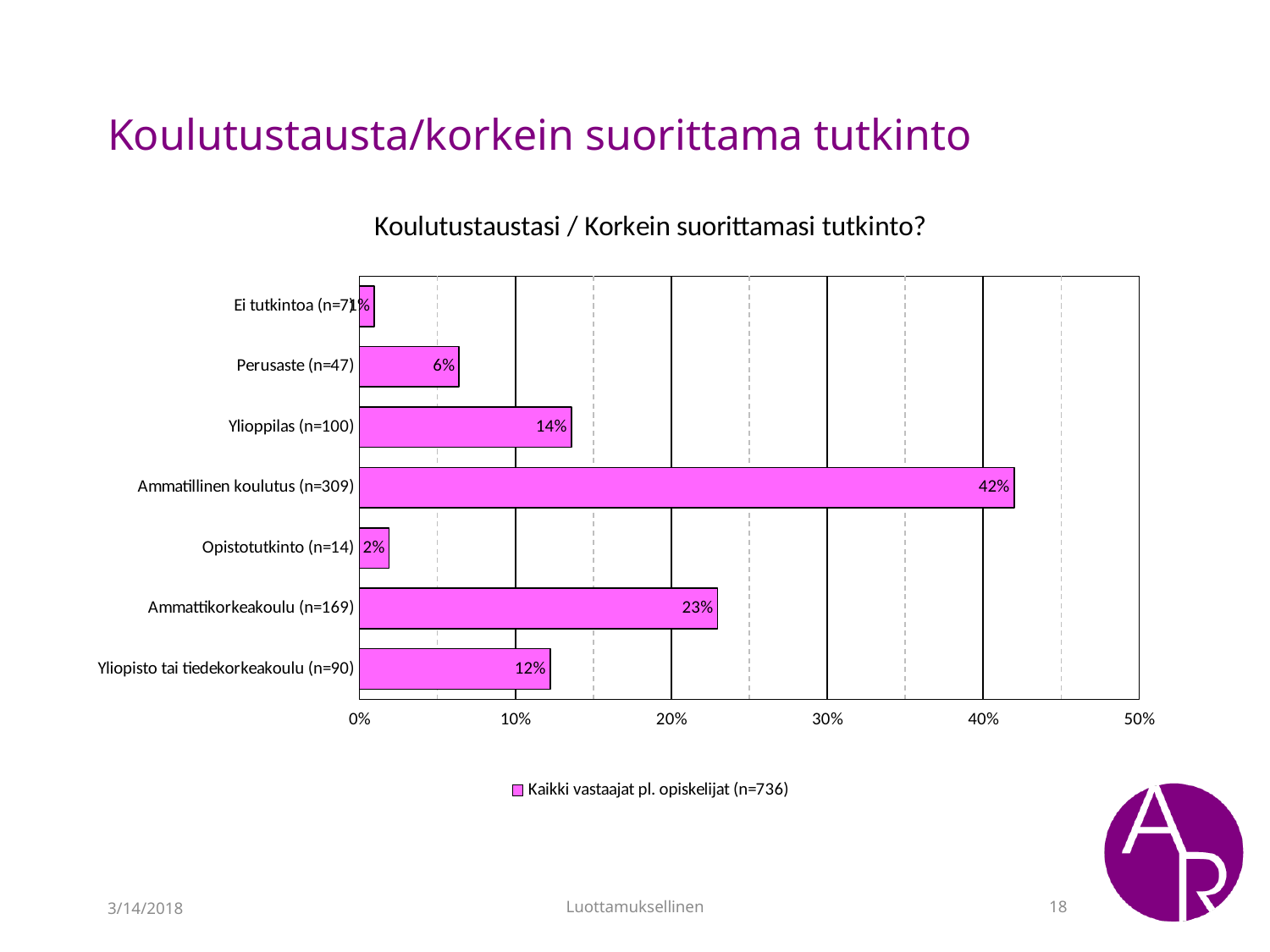
What is the value for Ammatillinen koulutus (n=309)? 42% What is the legend entry of the chart? Kaikki vastaajat pl. opiskelijat (n=736) Which is larger, the value for Ylioppilas (n=100) or the value for Yliopisto tai tiedekorkeakoulu (n=90)? Ylioppilas (n=100) What is the difference between the values for Ammatillinen koulutus (n=309) and Ammattikorkeakoulu (n=169)? 19% What is the value for Perusaste (n=47)? 6% What is the value for Ylioppilas (n=100)? 14% What is the value for Ammattikorkeakoulu (n=169)? 23% Is the value for Ammattikorkeakoulu (n=169) greater or less than 20%? greater What kind of chart is shown on the slide? Bar chart How many categories are shown in the chart? 7 Which category has the highest value? Ammatillinen koulutus (n=309) What is the value for Yliopisto tai tiedekorkeakoulu (n=90)? 12%